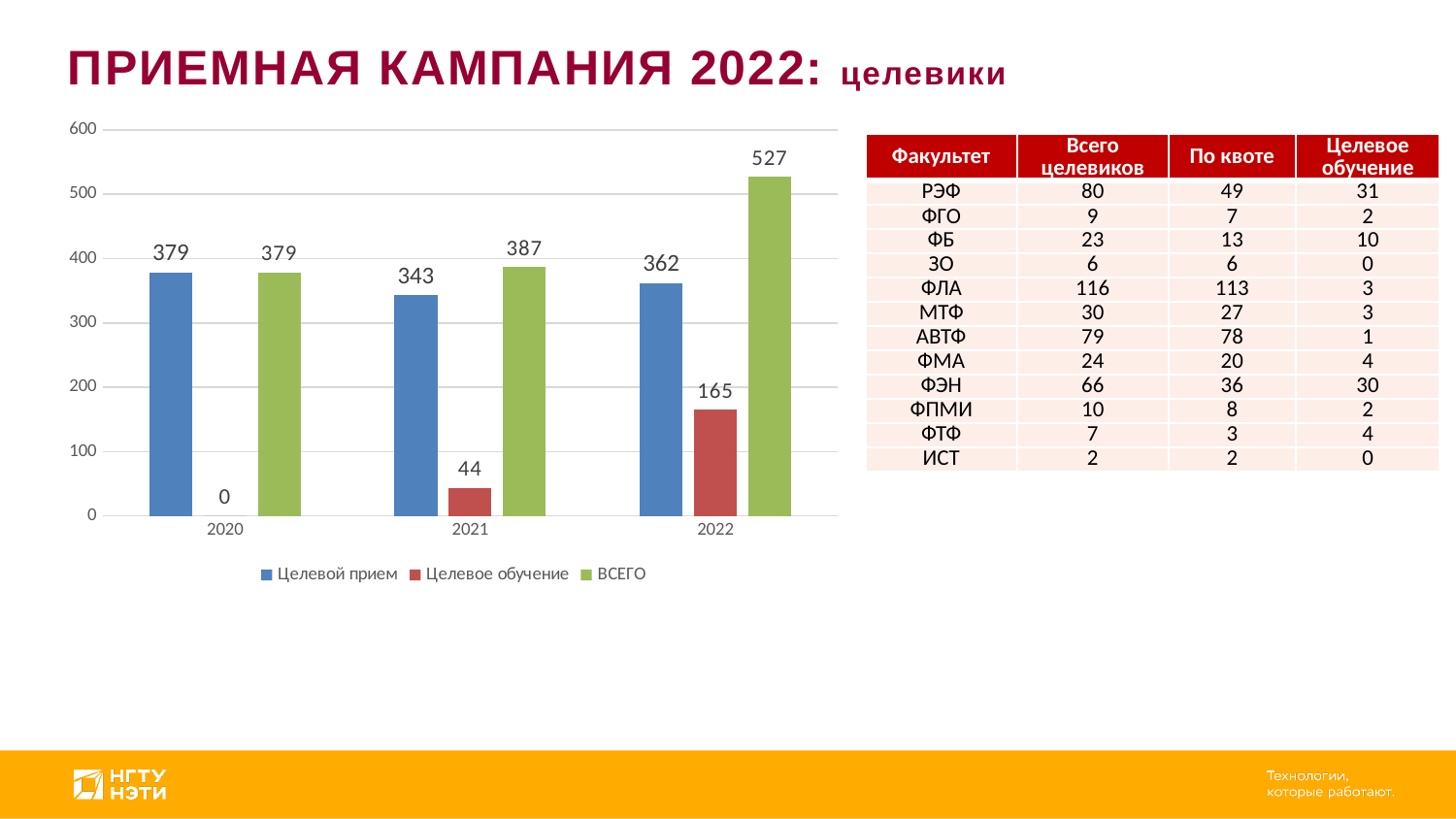
Which is larger: Целевой прием for 2020 or Целевой прием for 2022? 2020 In which year is the ВСЕГО value highest? 2022 What is the value of ВСЕГО for 2022? 527 What type of chart is shown on the slide? bar chart What is the difference between the ВСЕГО values for 2022 and 2021? 140 Does the Целевое обучение value rise or fall from 2020 to 2022? rise In which year is the Целевой прием value lowest? 2021 What is the value of Целевое обучение for 2020? 0 What is the value of Целевой прием for 2021? 343 How many series does the chart legend list? 3 What is the value of Целевое обучение for 2021? 44 How many years are shown on the x axis of the chart? 3